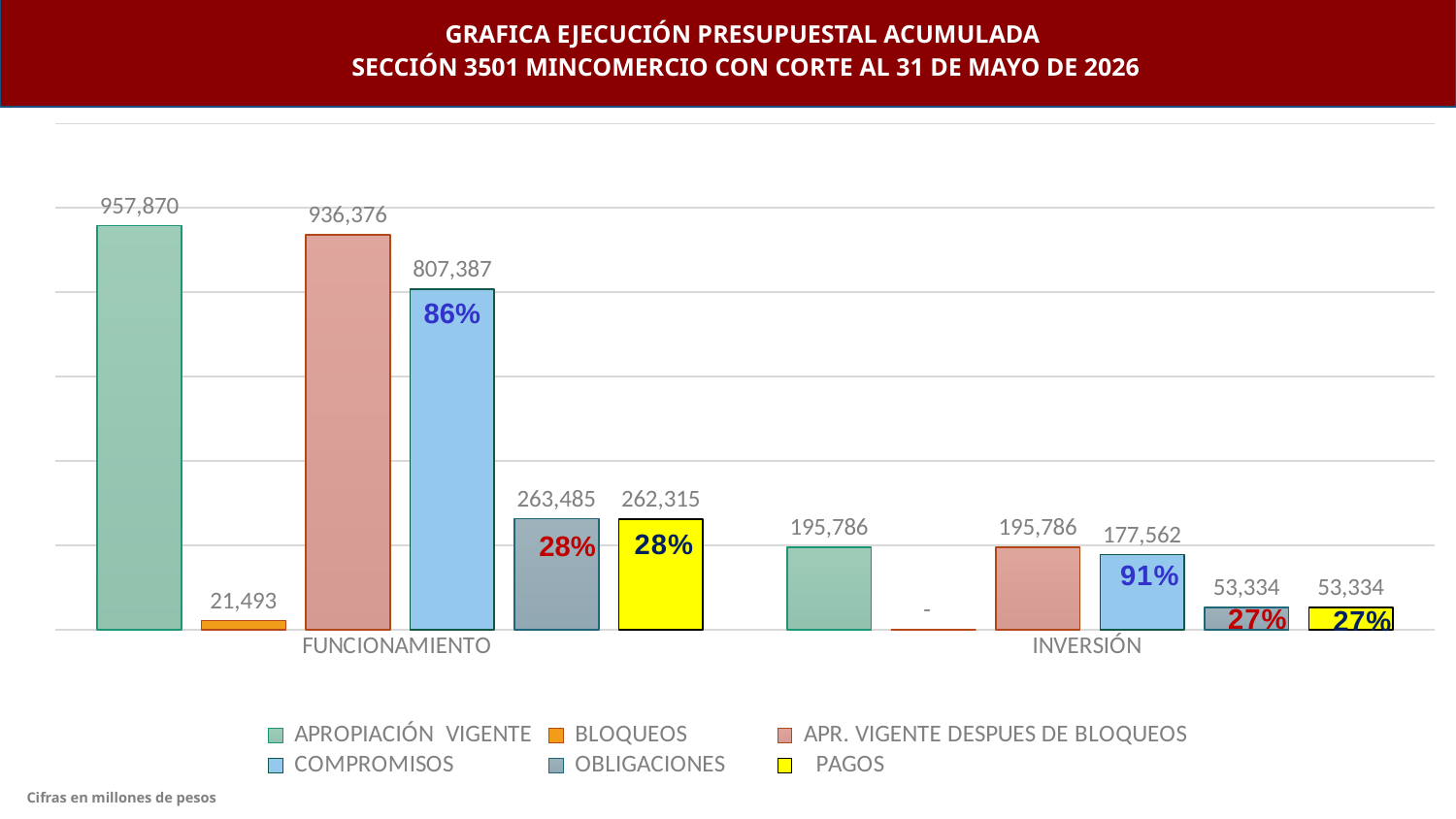
Which series has the lowest value for FUNCIONAMIENTO? BLOQUEOS How many series does the legend list? 6 What is the PAGOS value for INVERSIÓN? 53,334 What percentage is shown on the COMPROMISOS bar for INVERSIÓN? 91% How many categories are shown on the x axis? 2 What is the COMPROMISOS value for INVERSIÓN? 177,562 What type of chart is shown on the slide? bar chart What is the BLOQUEOS value for FUNCIONAMIENTO? 21,493 What is the difference between the OBLIGACIONES and PAGOS values for FUNCIONAMIENTO? 1,170 Which series has the highest value for FUNCIONAMIENTO? APROPIACIÓN VIGENTE What is the APROPIACIÓN VIGENTE value for FUNCIONAMIENTO? 957,870 Which is larger, the COMPROMISOS value for FUNCIONAMIENTO or the COMPROMISOS value for INVERSIÓN? FUNCIONAMIENTO